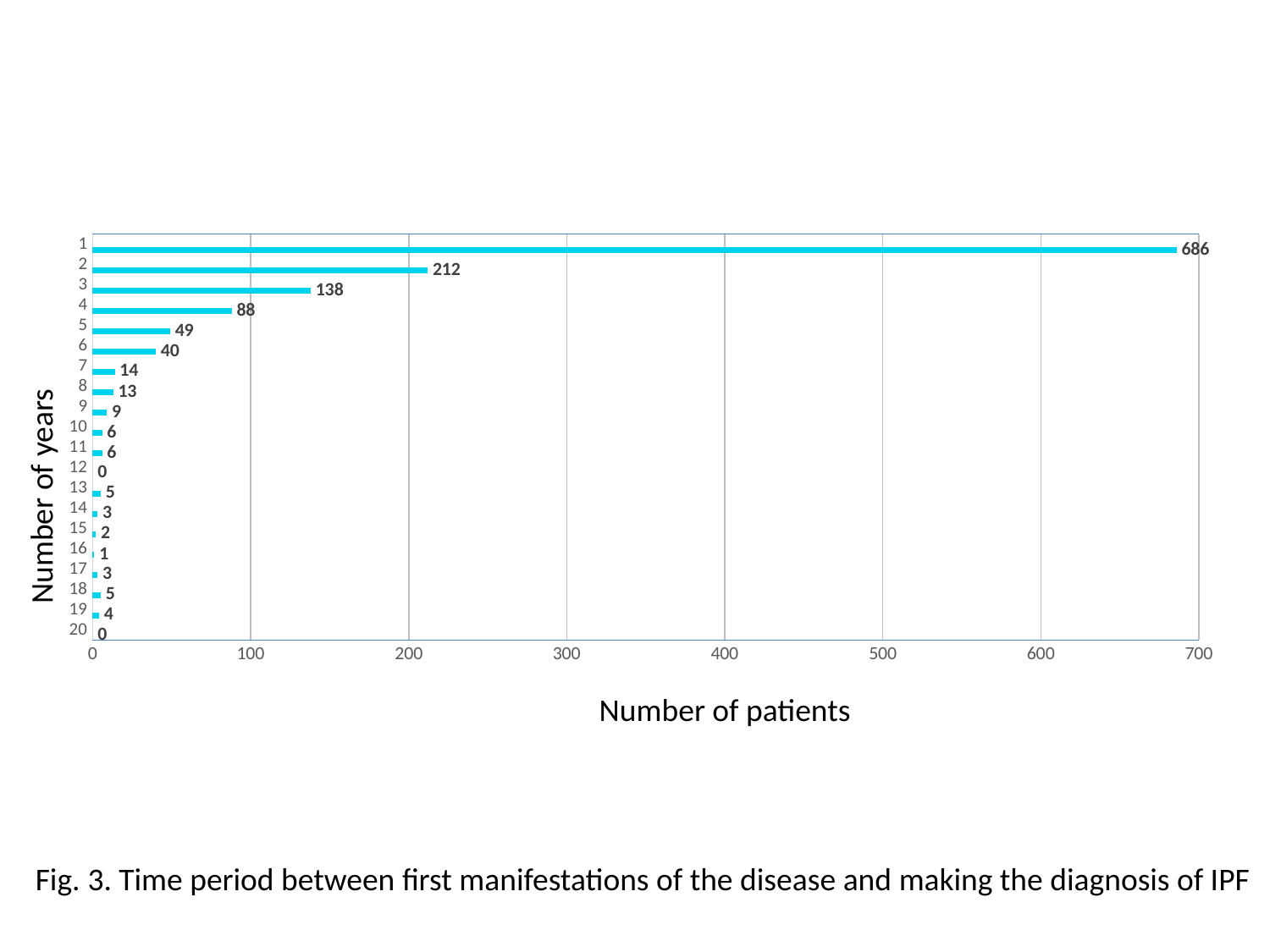
How many patients had a time period of 1 year between first manifestations and diagnosis? 686 What kind of chart is shown on the slide? bar chart What is the number of patients for 6 years? 40 What is the number of patients for 3 years? 138 Which has more patients, 7 years or 8 years? 7 years How many year categories are shown on the y axis? 20 What is the label of the x axis? Number of patients Is the number of patients for 2 years greater or less than 200? greater What is the difference in number of patients between 1 year and 2 years? 474 What is the label of the y axis? Number of years Which number of years has the highest number of patients? 1 What is the difference in number of patients between 4 years and 5 years? 39